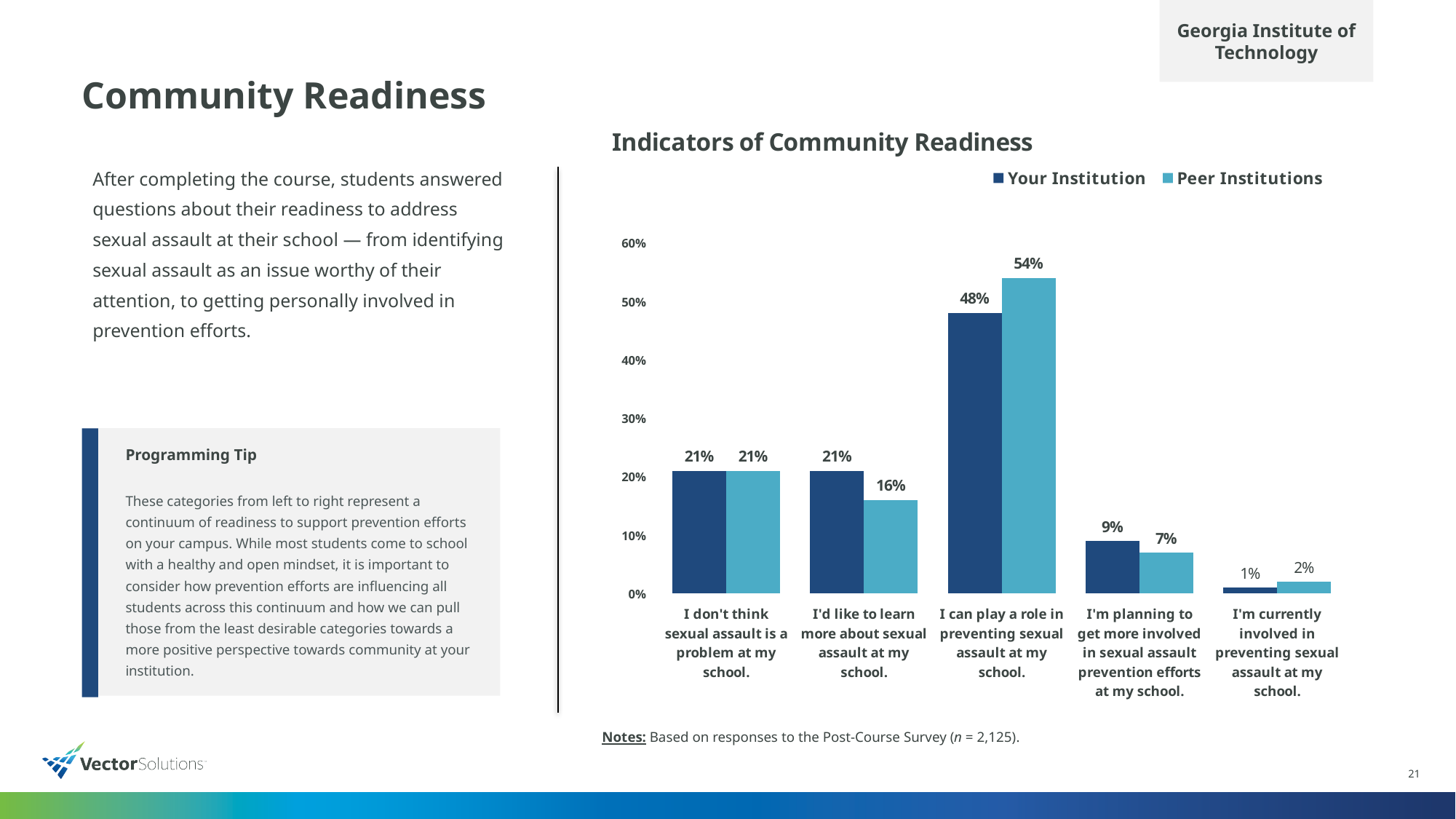
How many categories are shown on the x axis of the chart? 5 What kind of chart is shown on the slide? Bar chart Which category has the highest Peer Institutions value? I can play a role in preventing sexual assault at my school. What is the Your Institution value for "I can play a role in preventing sexual assault at my school."? 48% What is the difference between the Peer Institutions and Your Institution values for "I can play a role in preventing sexual assault at my school."? 6% What is the Peer Institutions value for "I'm currently involved in preventing sexual assault at my school."? 2% Is the Your Institution value for "I can play a role in preventing sexual assault at my school." greater or less than 40%? greater How many series does the chart legend list? 2 What is the Peer Institutions value for "I'd like to learn more about sexual assault at my school."? 16% For "I'm planning to get more involved in sexual assault prevention efforts at my school.", which series has the larger value, Your Institution or Peer Institutions? Your Institution Which category has the lowest Your Institution value? I'm currently involved in preventing sexual assault at my school. What is the title of the chart? Indicators of Community Readiness